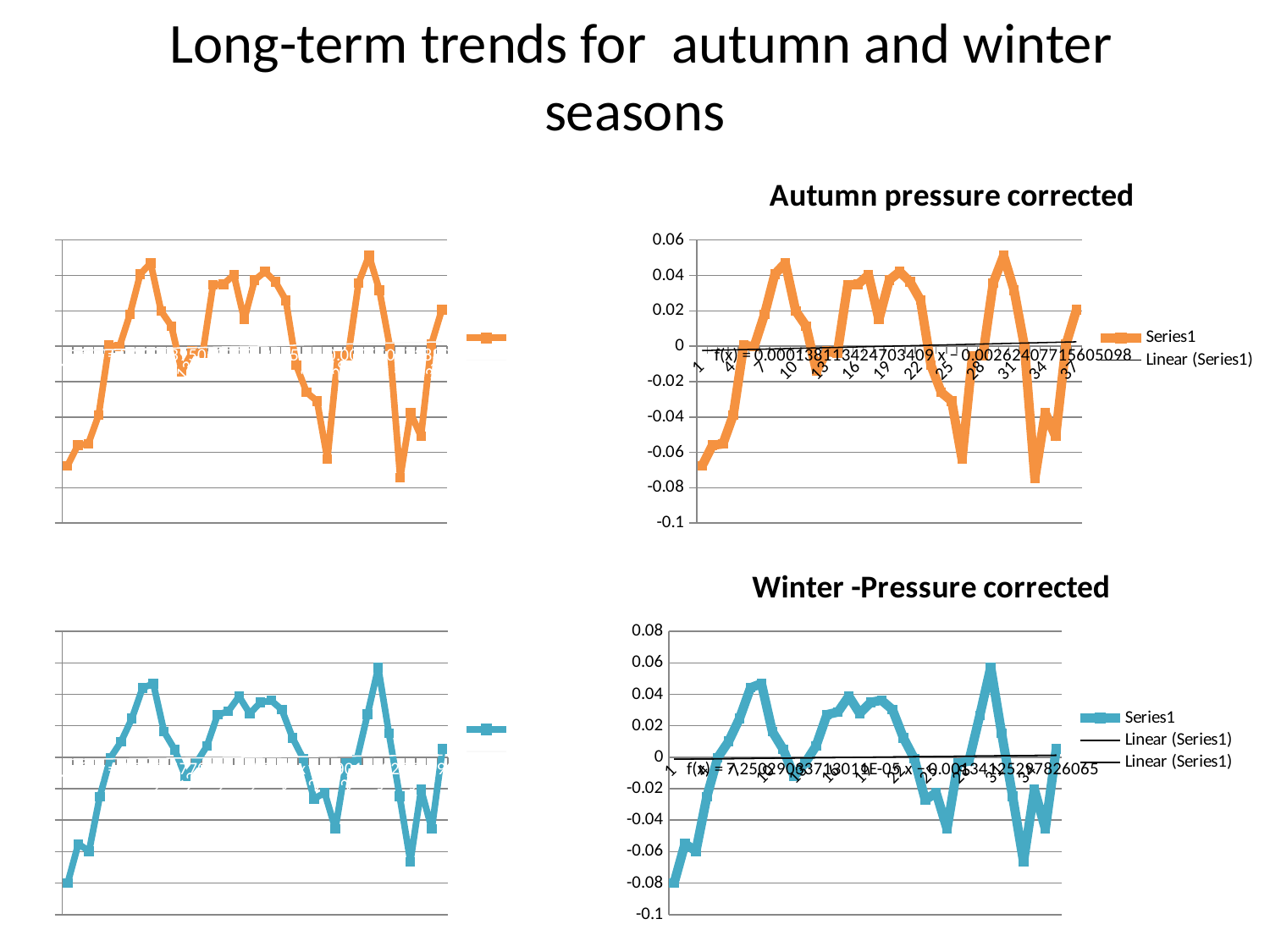
In the 'Winter -Pressure corrected' chart, is the highest peak of Series1 greater or less than 0.04? greater In the 'Winter -Pressure corrected' chart, what colour is the Series1 line? blue In the 'Winter -Pressure corrected' chart, is the value of Series1 at x = 1 greater or less than -0.06? less In the 'Autumn pressure corrected' chart, is the value of Series1 at x = 1 greater or less than -0.06? less In the 'Winter -Pressure corrected' chart, how many entries does the legend list? 3 In the 'Winter -Pressure corrected' chart, which is larger: the Series1 value at x = 1 or at x = 31? x = 31 In the 'Autumn pressure corrected' chart, how many entries does the legend list? 2 What is the title of the chart in the top-right of the slide? Autumn pressure corrected In the 'Autumn pressure corrected' chart, what kind of chart is shown? line chart